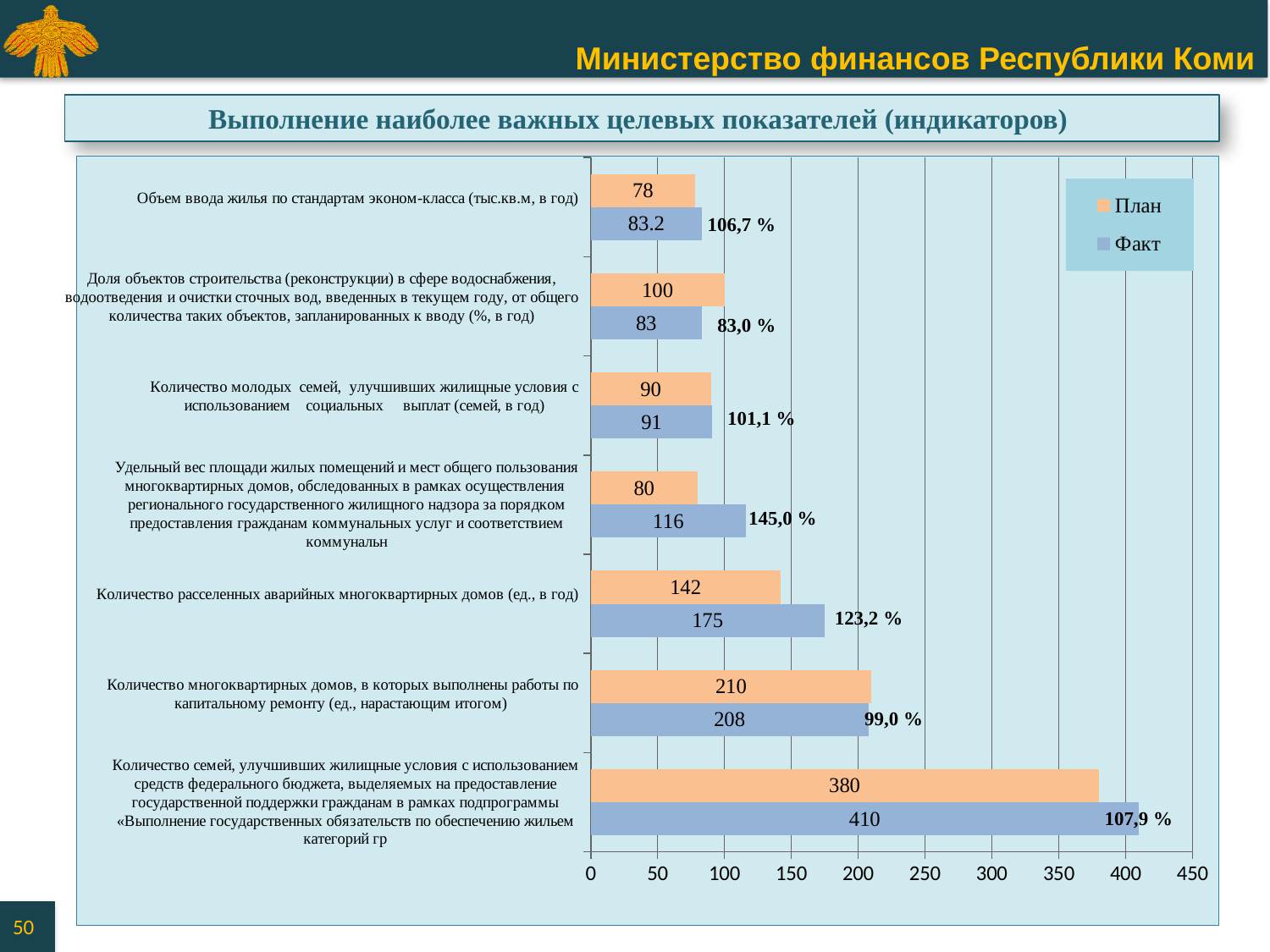
What kind of chart is shown on the slide? Bar chart What is the difference between the Факт and План values for "Количество расселенных аварийных многоквартирных домов (ед., в год)"? 33 Which category has the highest Факт value? Количество семей, улучшивших жилищные условия с использованием средств федерального бюджета... How many series does the legend list? 2 Which category has the lowest План value? Объем ввода жилья по стандартам эконом-класса (тыс.кв.м, в год) For "Количество многоквартирных домов, в которых выполнены работы по капитальному ремонту", which is larger: План or Факт? План What are the two series named in the legend? План and Факт Is the Факт value for "Количество семей, улучшивших жилищные условия..." greater or less than 400? greater What percentage is shown next to the Факт bar for "Удельный вес площади жилых помещений и мест общего пользования многоквартирных домов..."? 145,0 % How many categories are shown on the chart? 7 What is the План value for "Количество расселенных аварийных многоквартирных домов (ед., в год)"? 142 What is the Факт value for "Объем ввода жилья по стандартам эконом-класса (тыс.кв.м, в год)"? 83.2